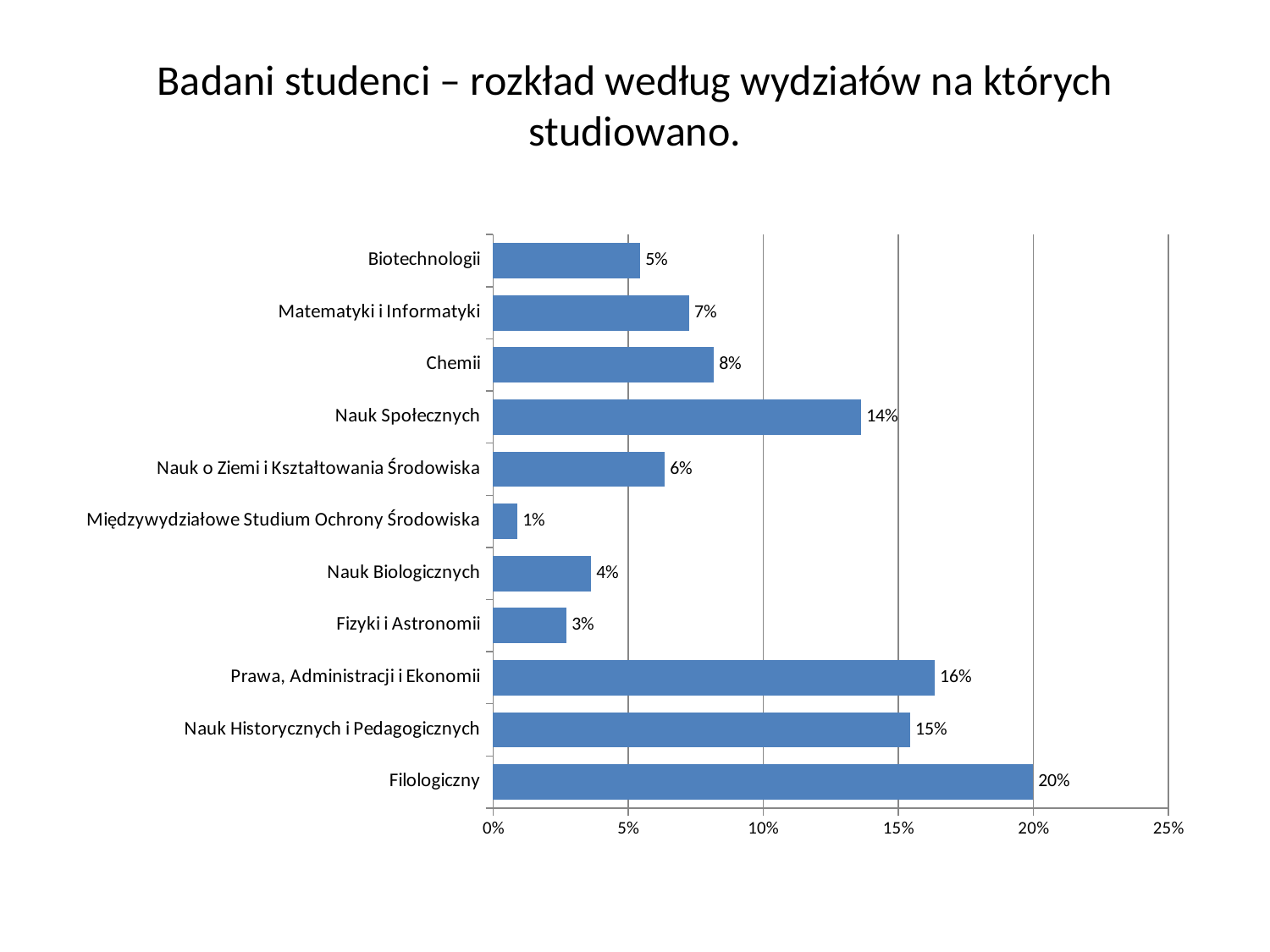
What is the value for Fizyki i Astronomii? 3% What is the value for Nauk Społecznych? 14% What is the value for Filologiczny? 20% Which is larger, the value for Chemii or the value for Nauk Biologicznych? Chemii What is the difference between the values for Filologiczny and Prawa, Administracji i Ekonomii? 4% What is the maximum value shown on the x axis? 25% What kind of chart is shown on the slide? bar chart How many categories are shown in the chart? 11 Which category has the highest value? Filologiczny Which category has the lowest value? Międzywydziałowe Studium Ochrony Środowiska Is the value for Nauk Historycznych i Pedagogicznych greater or less than 10%? greater What is the value for Międzywydziałowe Studium Ochrony Środowiska? 1%